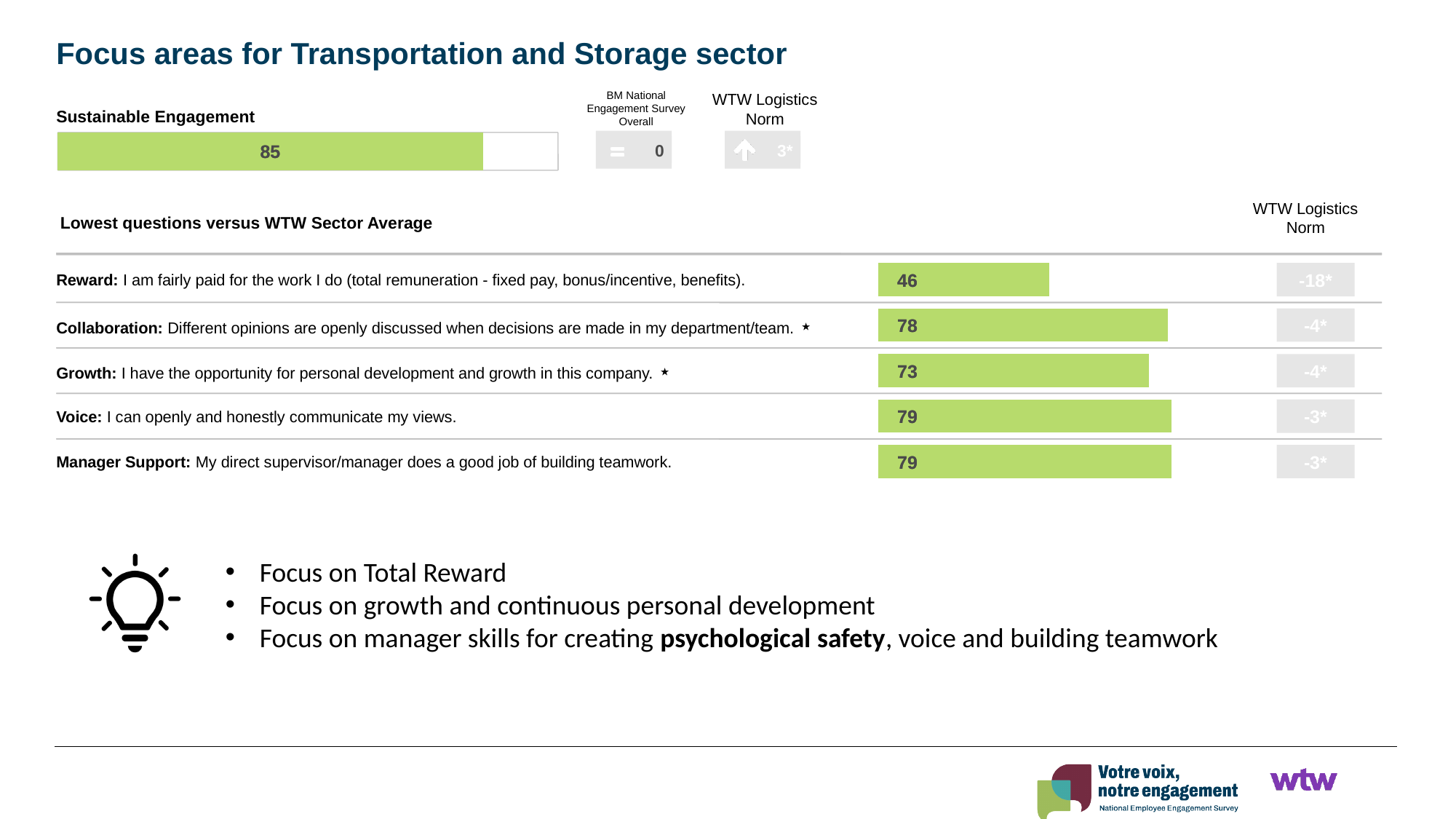
In the Lowest questions versus WTW Sector Average chart, which question has the lowest score? Reward In the Lowest questions versus WTW Sector Average chart, what is the value for Collaboration? 78 In the Lowest questions versus WTW Sector Average chart, what is the value for Growth? 73 What is the WTW Logistics Norm difference shown next to the Sustainable Engagement bar? 3* In the Lowest questions versus WTW Sector Average chart, what is the value for Reward? 46 What kind of chart is used for the Lowest questions versus WTW Sector Average section? Bar chart How many questions are listed in the Lowest questions versus WTW Sector Average chart? 5 In the Lowest questions versus WTW Sector Average chart, which is larger, the Growth score or the Voice score? Voice In the Sustainable Engagement bar, what is the score shown? 85 In the Lowest questions versus WTW Sector Average chart, what is the difference between the Collaboration score and the Reward score? 32 In the Lowest questions versus WTW Sector Average chart, what is the WTW Logistics Norm difference shown for Reward? -18* In the Lowest questions versus WTW Sector Average chart, what is the WTW Logistics Norm difference shown for Manager Support? -3*